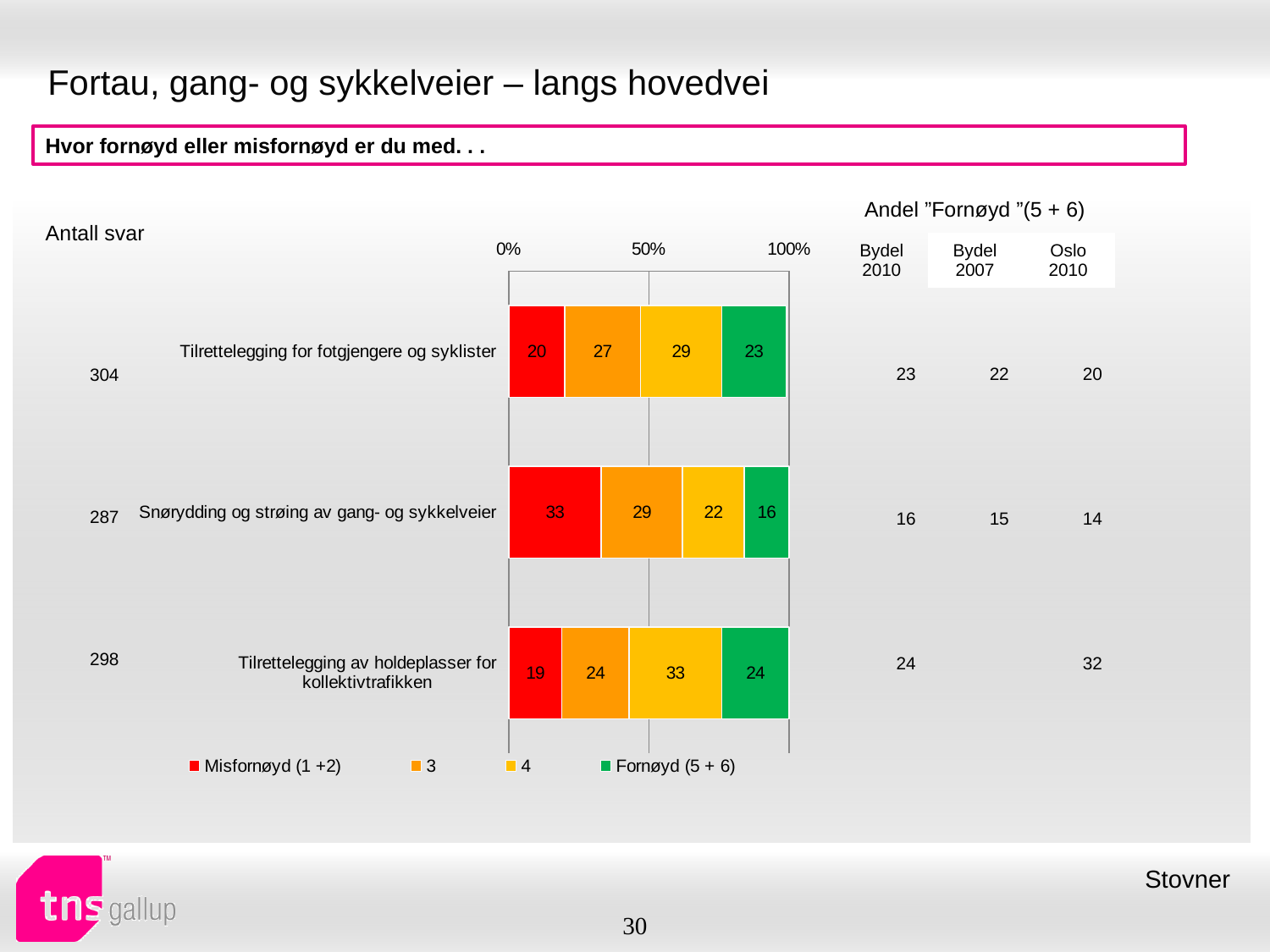
What is the total of the stacked bar for "Snørydding og strøing av gang- og sykkelveier"? 100 What is the difference between the Fornøyd (5 + 6) values for "Tilrettelegging av holdeplasser for kollektivtrafikken" and "Snørydding og strøing av gang- og sykkelveier"? 8 Which category has the highest Misfornøyd (1 +2) value? Snørydding og strøing av gang- og sykkelveier How many categories are shown in the chart? 3 What is the value of the "4" segment for "Tilrettelegging av holdeplasser for kollektivtrafikken"? 33 What is the value of the Misfornøyd (1 +2) segment for "Snørydding og strøing av gang- og sykkelveier"? 33 Which category has the lowest Fornøyd (5 + 6) value? Snørydding og strøing av gang- og sykkelveier What is the value of the "3" segment for "Tilrettelegging for fotgjengere og syklister"? 27 Which has the larger "4" segment: "Tilrettelegging av holdeplasser for kollektivtrafikken" or "Snørydding og strøing av gang- og sykkelveier"? Tilrettelegging av holdeplasser for kollektivtrafikken How many series does the legend list? 4 What kind of chart is shown on the slide? Stacked bar chart What is the value of the Fornøyd (5 + 6) segment for "Tilrettelegging for fotgjengere og syklister"? 23